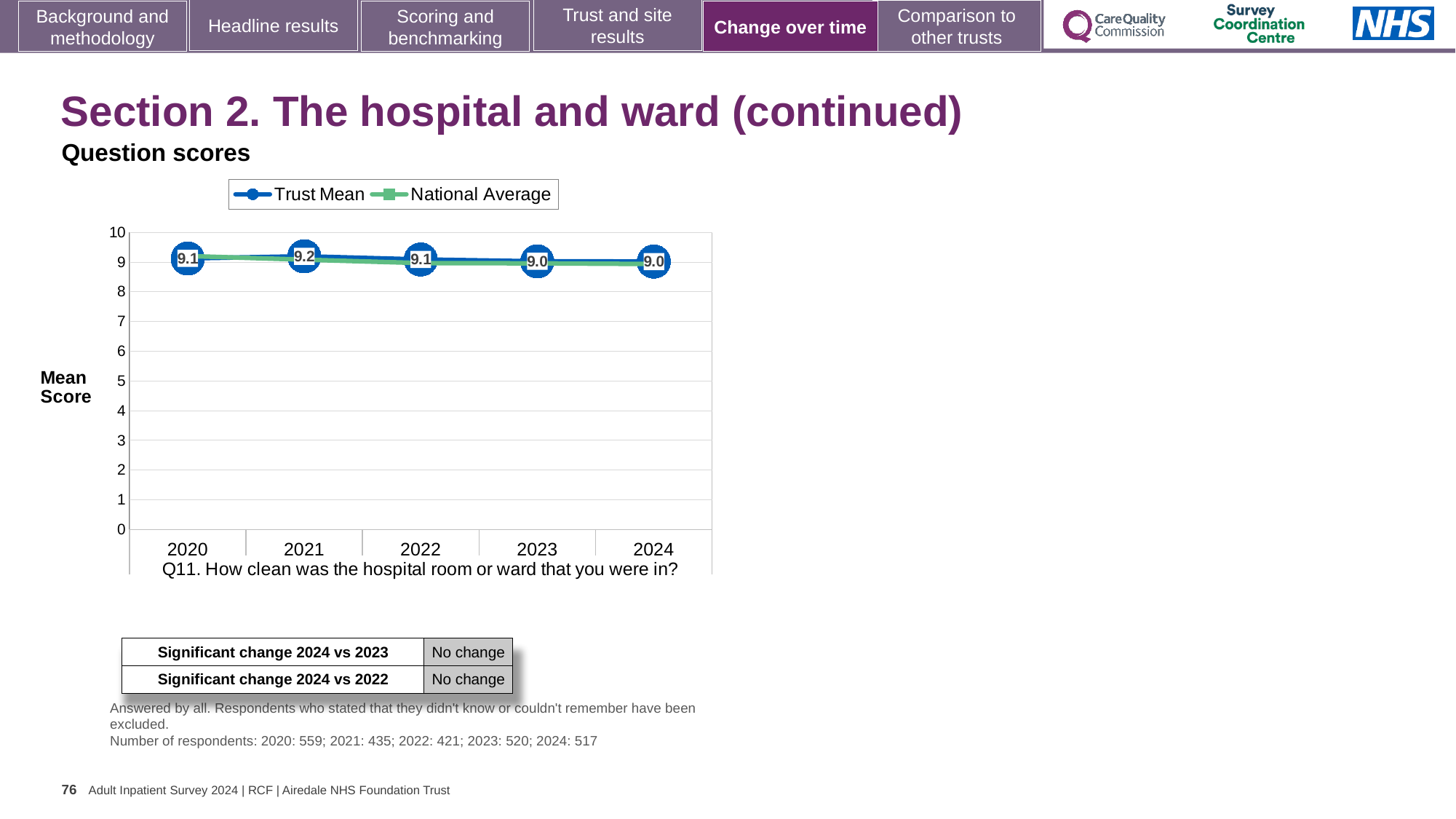
What kind of chart is shown on the slide? line chart What is the Trust Mean score for 2022? 9.1 Is the Trust Mean score in 2021 larger or smaller than in 2023? larger How many series does the legend list? 2 In which year is the Trust Mean score highest? 2021 Which survey question does the chart show scores for? Q11. How clean was the hospital room or ward that you were in? What is the Trust Mean score for 2024? 9.0 Is the National Average value for 2024 greater or less than 8? greater What is the difference between the Trust Mean score in 2021 and in 2024? 0.2 What is the Trust Mean score for 2020? 9.1 How many years are plotted on the x axis? 5 What is the Trust Mean score for 2021? 9.2